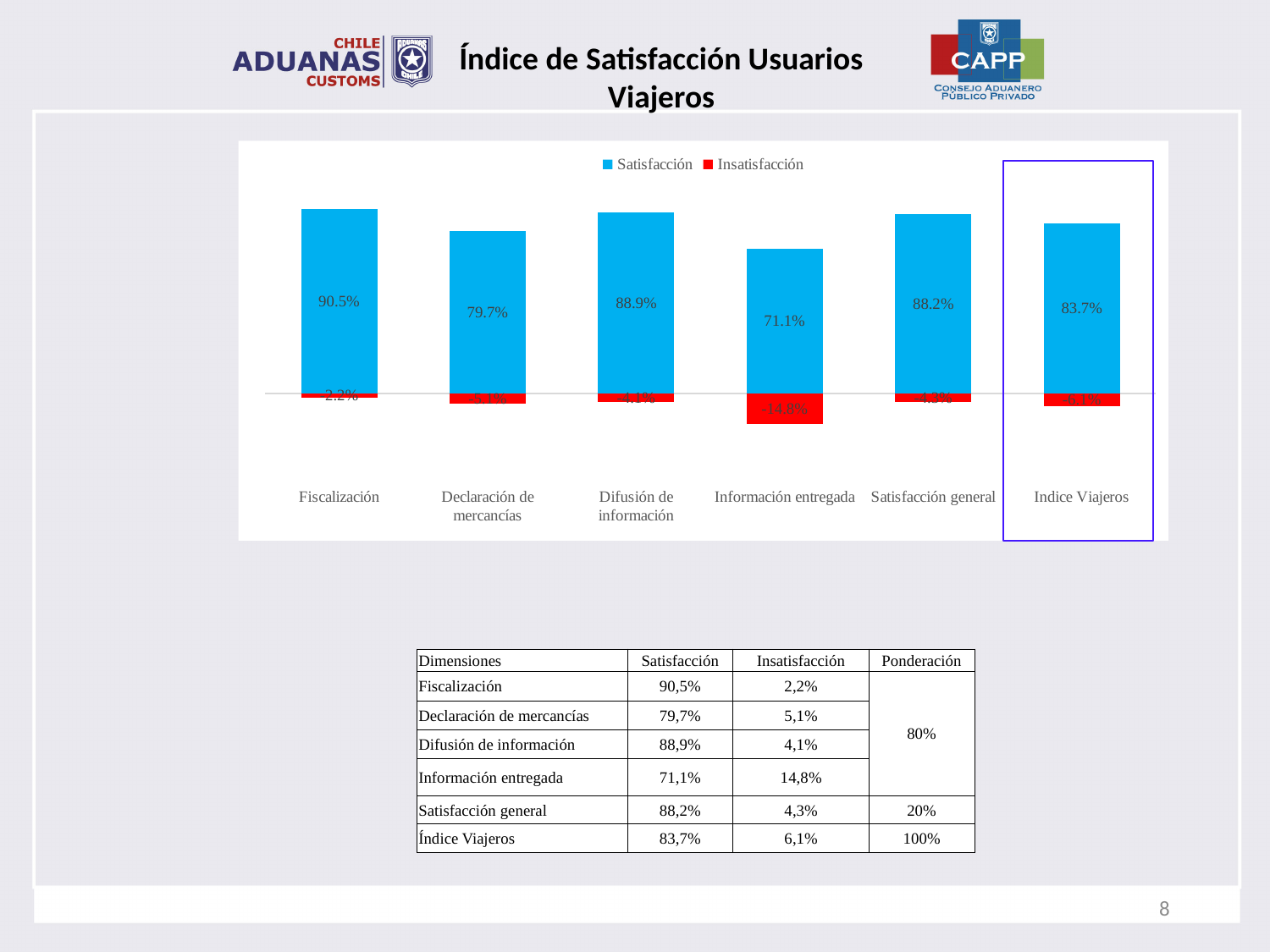
What is the Satisfacción value for Indice Viajeros? 83.7% How many categories are shown on the x axis of the chart? 6 Which has a higher Satisfacción value, Difusión de información or Satisfacción general? Difusión de información Which colour represents the Insatisfacción series in the chart? Red Which category has the lowest Satisfacción value? Información entregada What is the difference between the Satisfacción values for Fiscalización and Declaración de mercancías? 10.8% Which category has the highest Satisfacción value? Fiscalización What is the Satisfacción value for Información entregada? 71.1% How many series does the chart legend list? 2 What is the Insatisfacción value shown for Información entregada? -14.8% What is the Satisfacción value for Fiscalización? 90.5% What kind of chart is shown on the slide? Bar chart